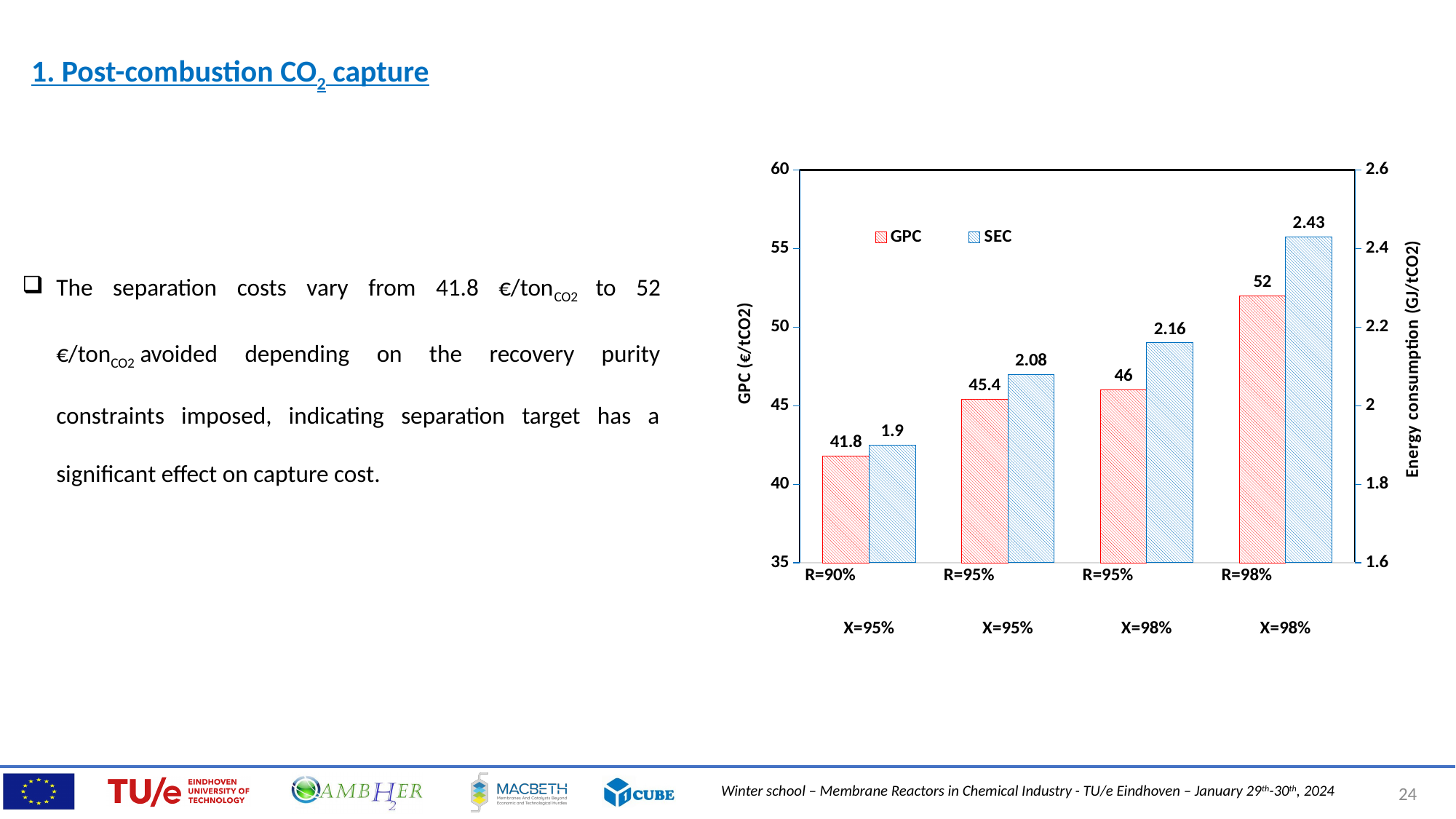
What type of chart is shown on the slide? bar chart How many series does the chart legend list? 2 What is the GPC value for the R=95%, X=95% case? 45.4 Which category has the highest GPC value? R=98%, X=98% Do the SEC values rise or fall from left to right along the x axis? rise What is the SEC value for the R=95%, X=98% case? 2.16 What is the GPC value for the R=90%, X=95% case? 41.8 Is the GPC value for the R=95%, X=98% case larger or smaller than the GPC value for the R=95%, X=95% case? larger Which category has the lowest SEC value? R=90%, X=95% What is the difference between the GPC values for the R=98%, X=98% case and the R=90%, X=95% case? 10.2 What is the SEC value for the R=98%, X=98% case? 2.43 How many categories are shown on the x axis of the chart? 4